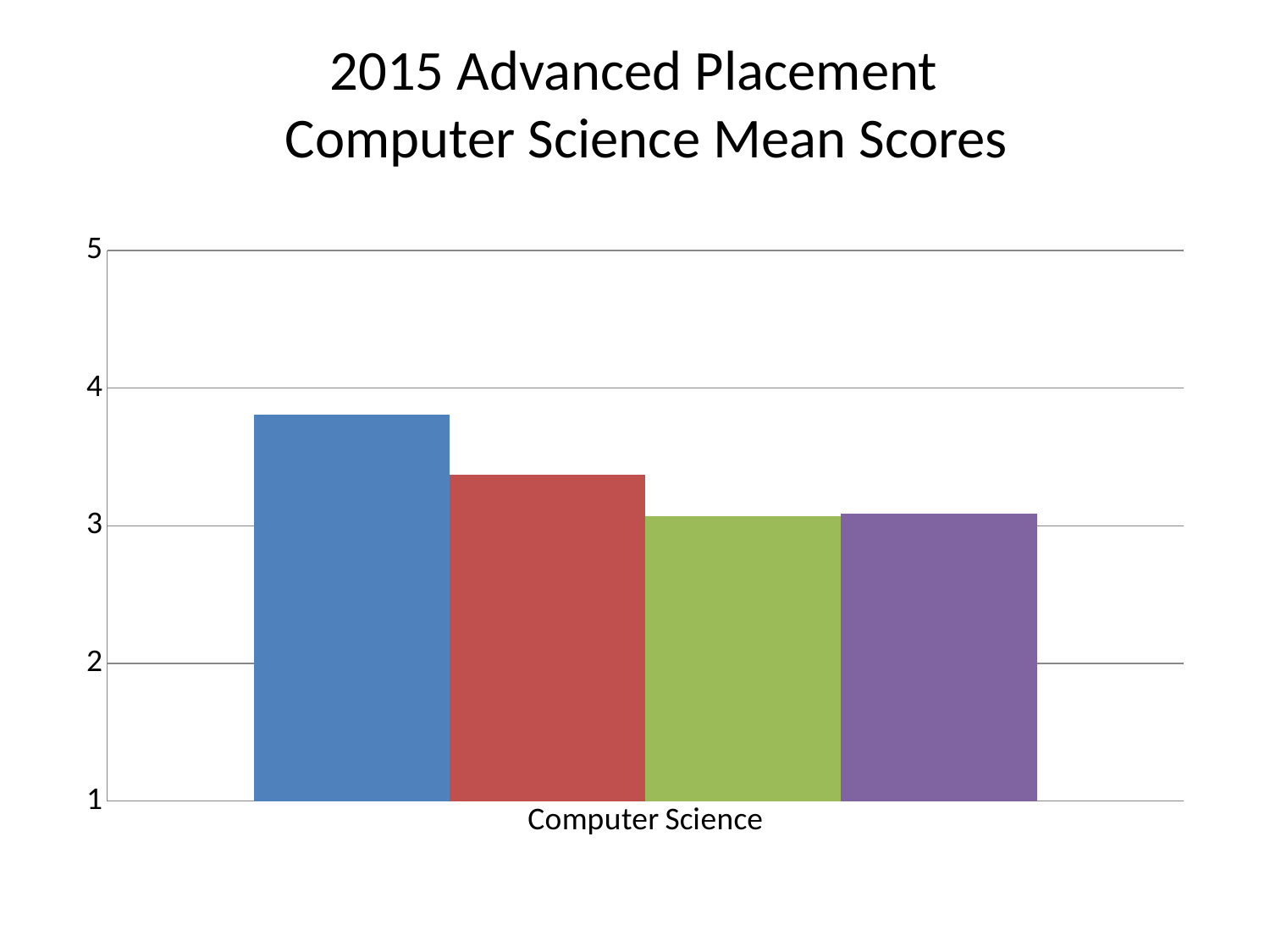
Which is larger, the value of the blue bar or the value of the red bar? the blue bar What kind of chart is shown on the slide? bar chart Is the value of the green bar greater or less than 4? less What is the category label shown on the x axis? Computer Science Which bar is the tallest in the chart? the blue bar Is the value of the red bar greater or less than 4? less Is the value of the purple bar greater or less than 2? greater What is the title of the chart? 2015 Advanced Placement Computer Science Mean Scores How many bars are plotted in the chart? 4